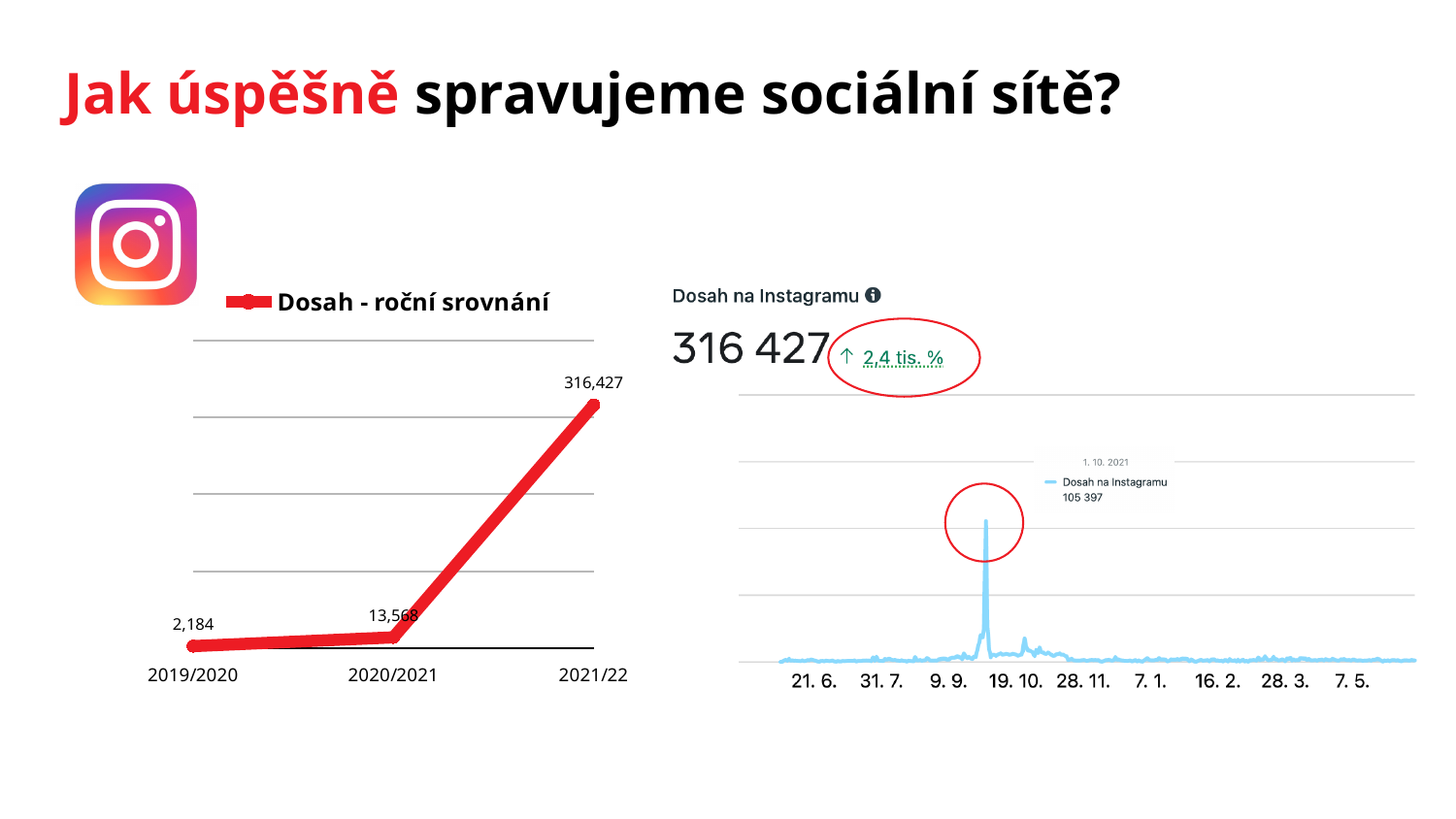
In the chart titled "Dosah na Instagramu" on the right, what total value is shown above the chart? 316 427 In the chart titled "Dosah - roční srovnání", what is the difference between the values for 2020/2021 and 2019/2020? 11,384 In the chart titled "Dosah - roční srovnání", how many periods are plotted on the x axis? 3 In the chart titled "Dosah na Instagramu" on the right, what percentage change is circled next to the total? 2,4 tis. % In the chart titled "Dosah - roční srovnání", what is the value for 2020/2021? 13,568 What kind of chart is the one titled "Dosah - roční srovnání"? line chart In the chart titled "Dosah - roční srovnání", do the values rise or fall from 2019/2020 to 2021/22? rise In the chart titled "Dosah - roční srovnání", what is the value for 2019/2020? 2,184 In the chart titled "Dosah - roční srovnání", which period has the highest value? 2021/22 In the chart titled "Dosah - roční srovnání", what is the value for 2021/22? 316,427 In the chart titled "Dosah na Instagramu" on the right, what value is shown in the tooltip for 1. 10. 2021? 105 397 In the chart titled "Dosah - roční srovnání", which period has the lowest value? 2019/2020